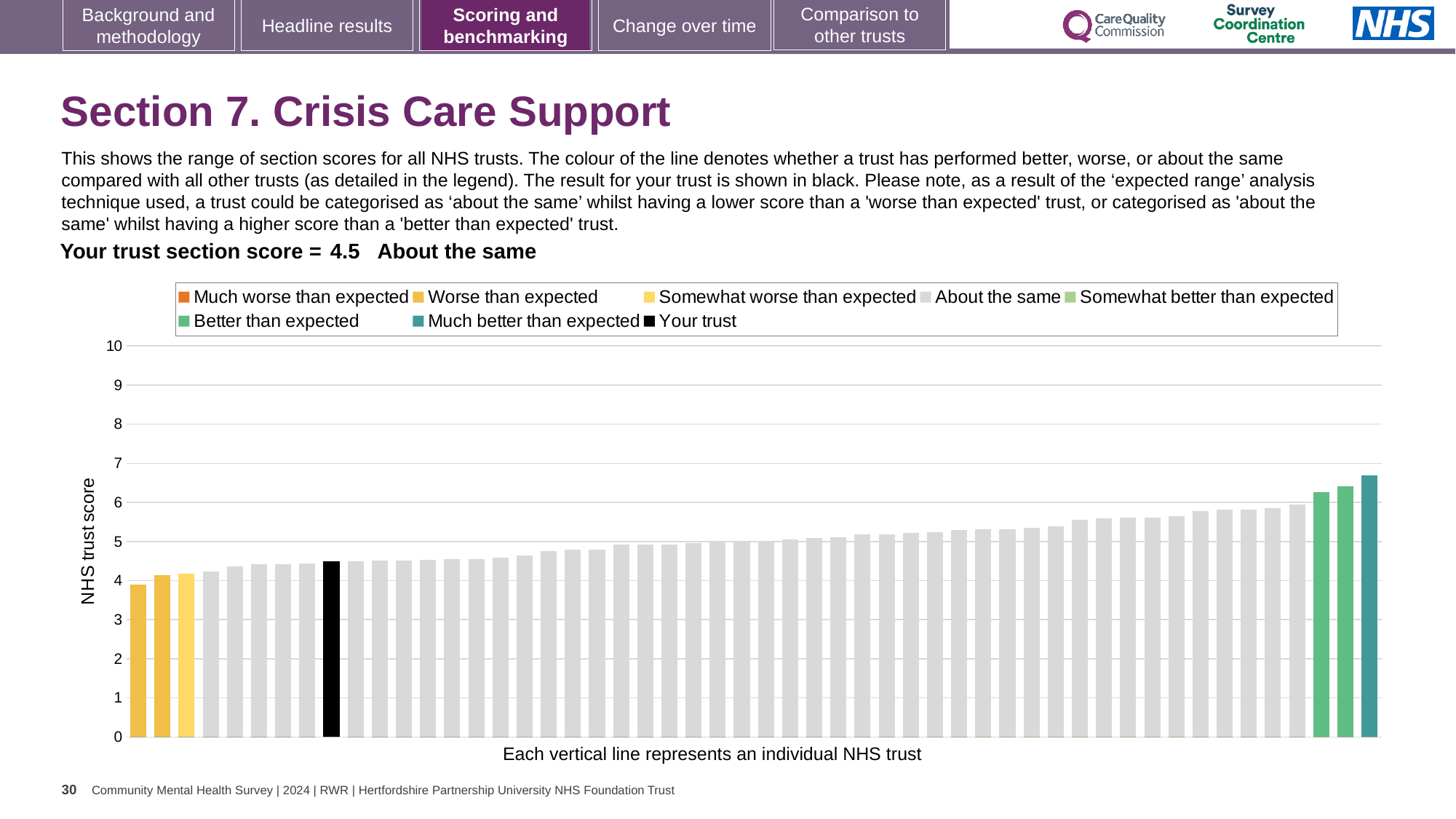
Is the value for your trust greater or less than 4? greater What is the section score for your trust shown on the slide? 4.5 What colour is the bar representing your trust? black How many bars are coloured as 'Much better than expected'? 1 Is the value for your trust greater or less than 5? less What is the label on the vertical axis of the chart? NHS trust score How many entries does the chart legend list? 8 Is the value of the highest bar greater or less than 6? greater What kind of chart is shown on the slide? bar chart How many bars are coloured as 'Better than expected'? 2 Do the bar values rise or fall from left to right along the x axis? rise